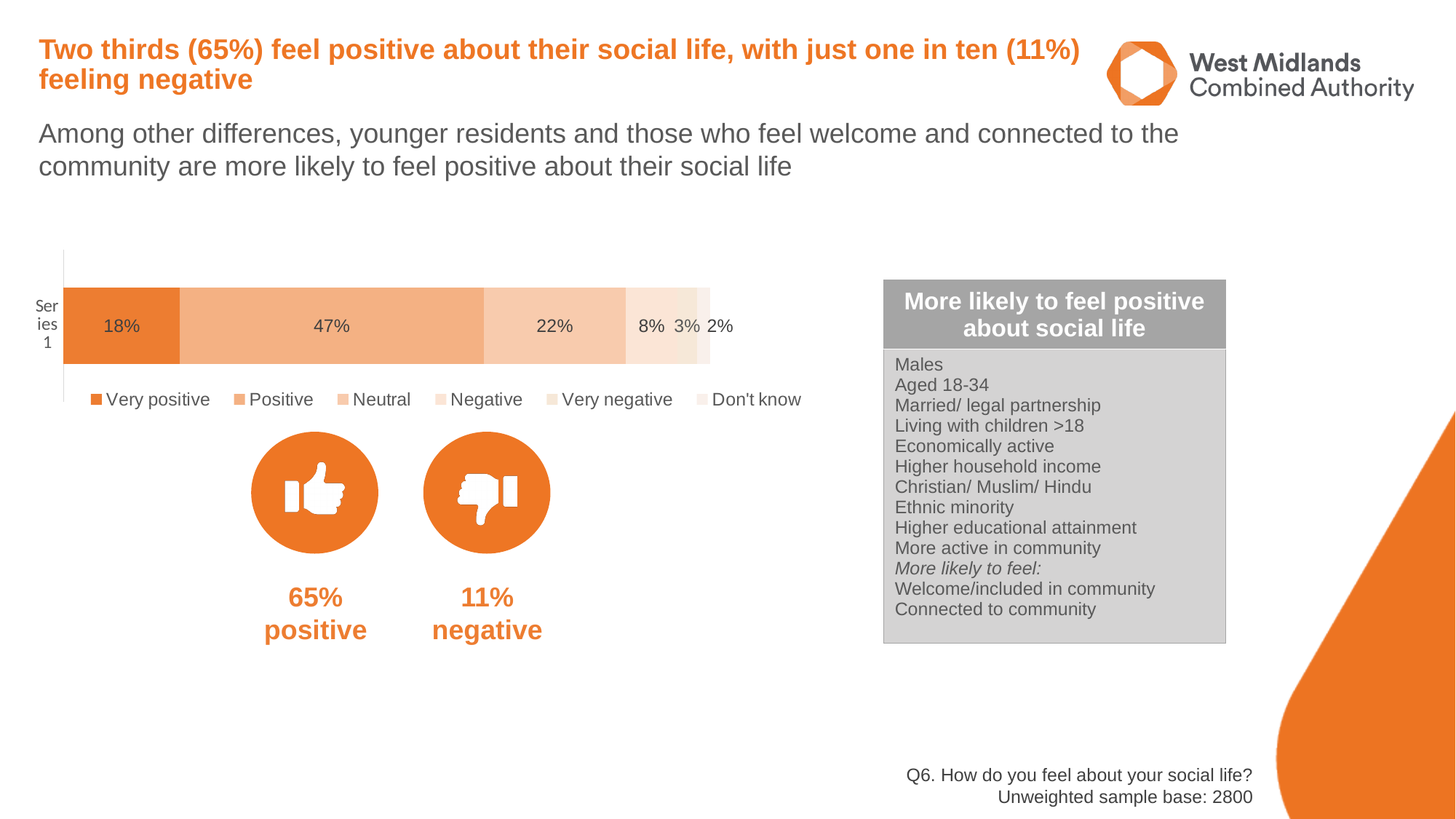
What percentage of respondents feel very positive about their social life? 18% What percentage of respondents answered 'Don't know'? 2% What is the difference between the 'Positive' and 'Neutral' shares? 25% What is the combined share of 'Negative' and 'Very negative' responses? 11% What percentage of respondents feel negative about their social life? 8% Which response category has the smallest share in the bar? Don't know What kind of chart is shown on the slide? Stacked bar chart Which is larger, the 'Very positive' share or the 'Neutral' share? Neutral What percentage of respondents feel neutral about their social life? 22% What percentage of respondents feel positive about their social life? 47% How many response categories does the legend list? 6 Which response category has the largest share in the bar? Positive